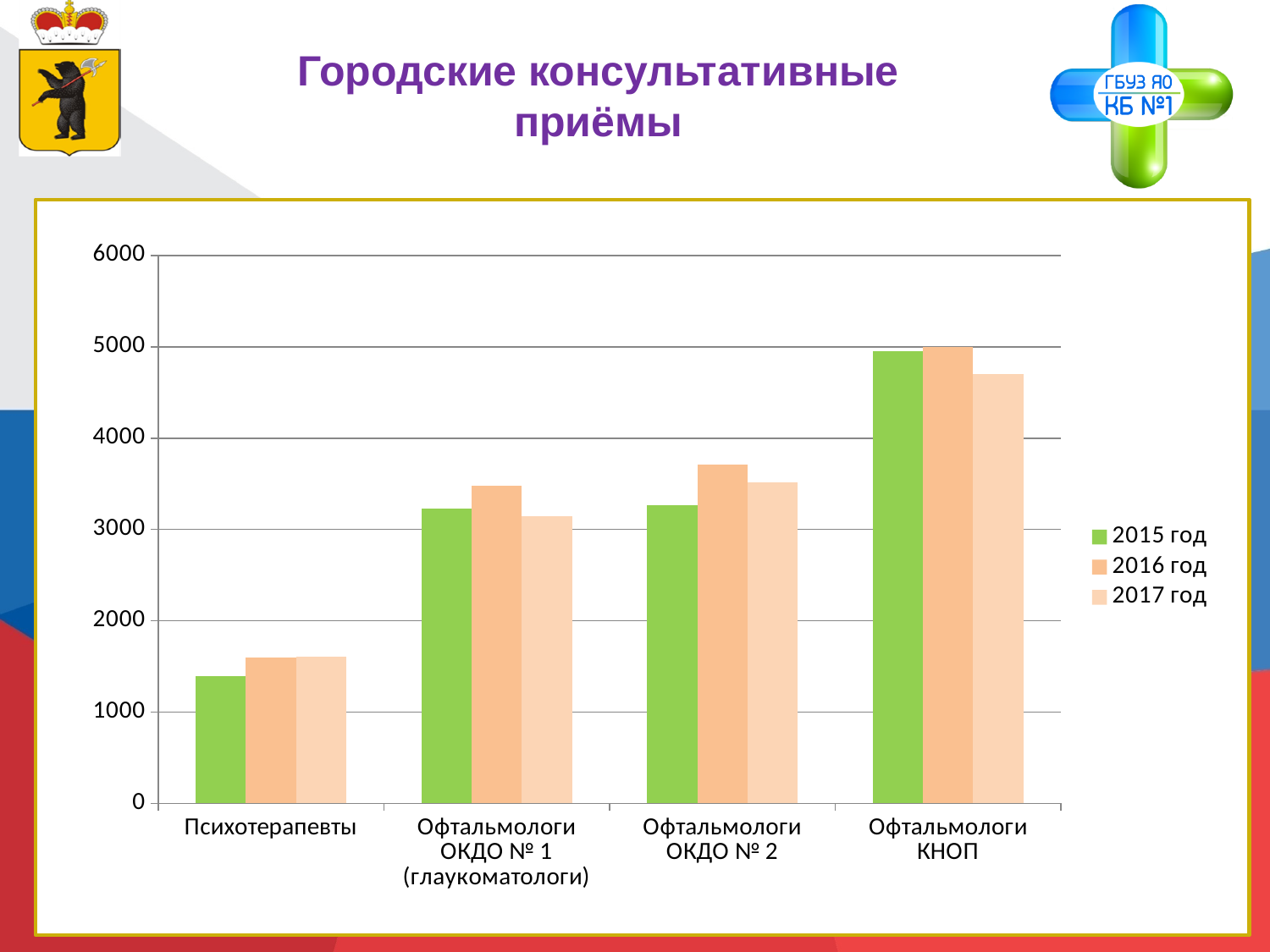
Which category has the lowest value for 2015 год? Психотерапевты Is the value for Офтальмологи ОКДО № 2 in 2016 год greater or less than 4000? less What is the title of the slide containing the chart? Городские консультативные приёмы Is the value for Офтальмологи ОКДО № 1 (глаукоматологи) in 2016 год greater or less than 3000? greater How many categories are shown on the x axis of the chart? 4 What kind of chart is shown on the slide? bar chart Is the value for Психотерапевты in 2015 год greater or less than 2000? less For 2016 год, which is larger: Офтальмологи ОКДО № 1 (глаукоматологи) or Офтальмологи ОКДО № 2? Офтальмологи ОКДО № 2 How many series does the legend list? 3 For Офтальмологи КНОП, which is larger: the value for 2015 год or for 2017 год? 2015 год Which category has the highest value for 2016 год? Офтальмологи КНОП